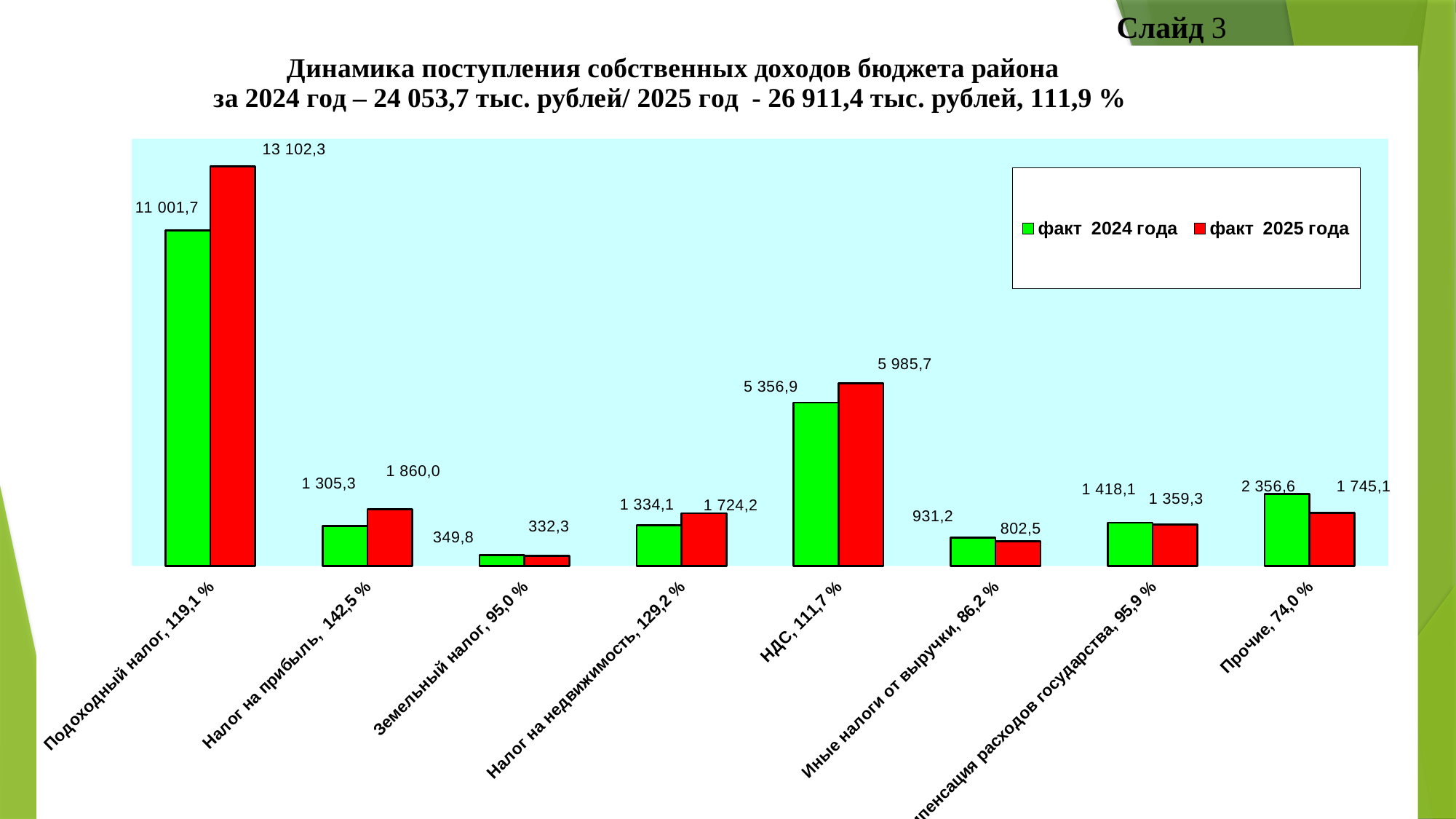
What is the value of факт 2025 года for НДС? 5 985,7 What is the value of факт 2024 года for Подоходный налог? 11 001,7 What kind of chart is shown on the slide? bar chart How many series does the legend list? 2 What is the value of факт 2024 года for Прочие? 2 356,6 What is the difference between факт 2025 года and факт 2024 года for Подоходный налог? 2 100,6 Which category has the highest value for факт 2025 года? Подоходный налог Which category has the lowest value for факт 2024 года? Земельный налог How many categories are shown on the x axis of the chart? 8 What is the value of факт 2025 года for Налог на прибыль? 1 860,0 For Иные налоги от выручки, which is larger: факт 2024 года or факт 2025 года? факт 2024 года What is the difference between факт 2024 года and факт 2025 года for Прочие? 611,5